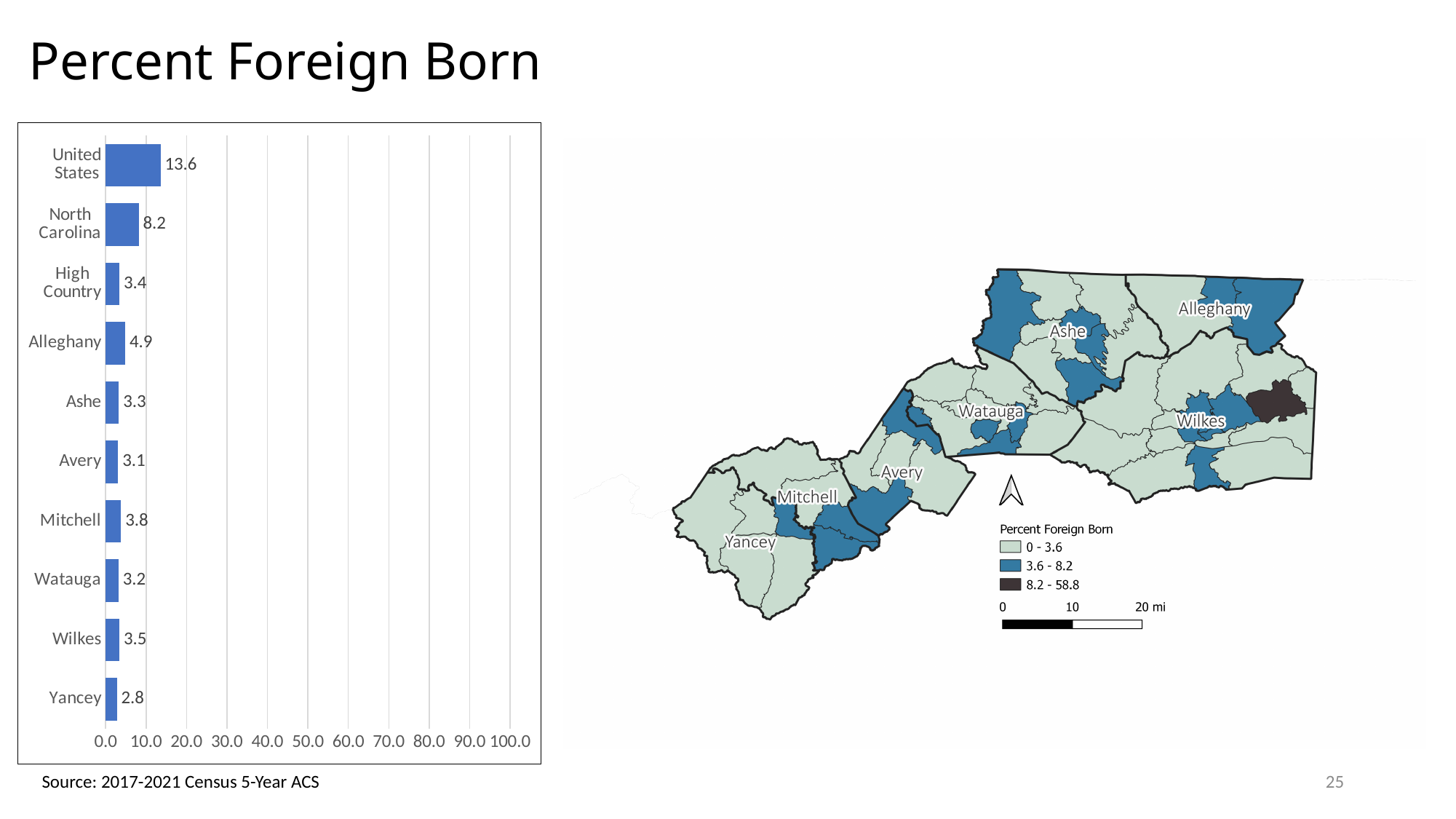
What is the value shown for Alleghany in the bar chart? 4.9 What is the value shown for North Carolina in the bar chart? 8.2 What is the percent foreign born value for the United States in the bar chart? 13.6 Which category has the highest value in the bar chart? United States What is the difference between the United States value and the North Carolina value in the bar chart? 5.4 What kind of chart is shown on the left of the slide? Bar chart What is the value shown for Yancey in the bar chart? 2.8 How many categories are shown in the bar chart? 10 Which category has the lowest value in the bar chart? Yancey What is the highest value on the x axis of the bar chart? 100.0 Which has a larger value in the bar chart, Mitchell or Watauga? Mitchell Is the value for the United States in the bar chart greater or less than 10.0? greater